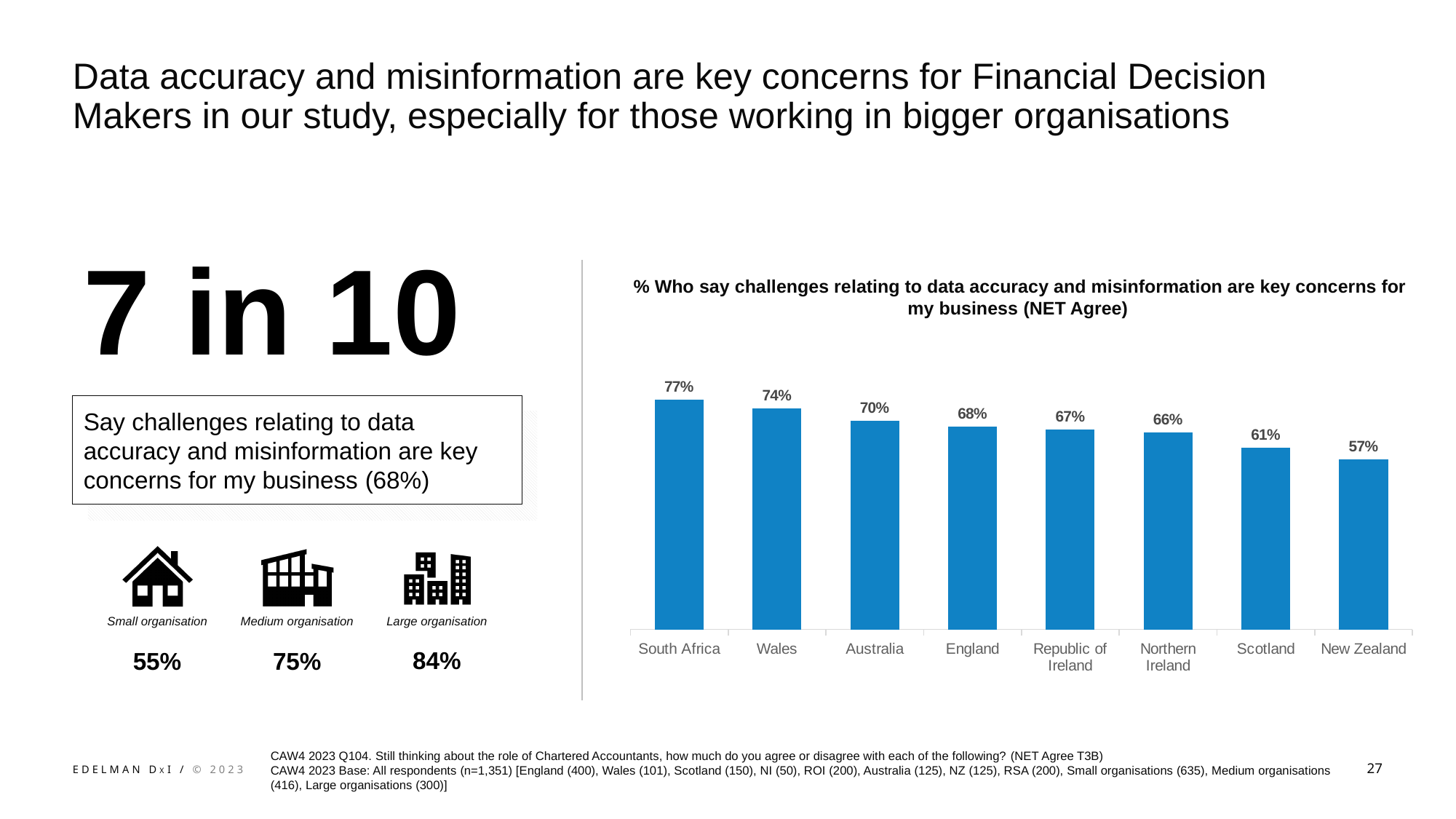
What is the value for Republic of Ireland? 67% What is the title of the chart? % Who say challenges relating to data accuracy and misinformation are key concerns for my business (NET Agree) How many countries are shown in the chart? 8 What is the difference between the values for Wales and England? 6 percentage points Which has a higher value, Australia or Northern Ireland? Australia What is the value for South Africa? 77% What kind of chart is shown? Bar chart Which country has the lowest value? New Zealand What is the value for Scotland? 61% What is the difference between the values for South Africa and New Zealand? 20 percentage points Do the values rise or fall from left to right across the chart? Fall Which country has the highest value? South Africa